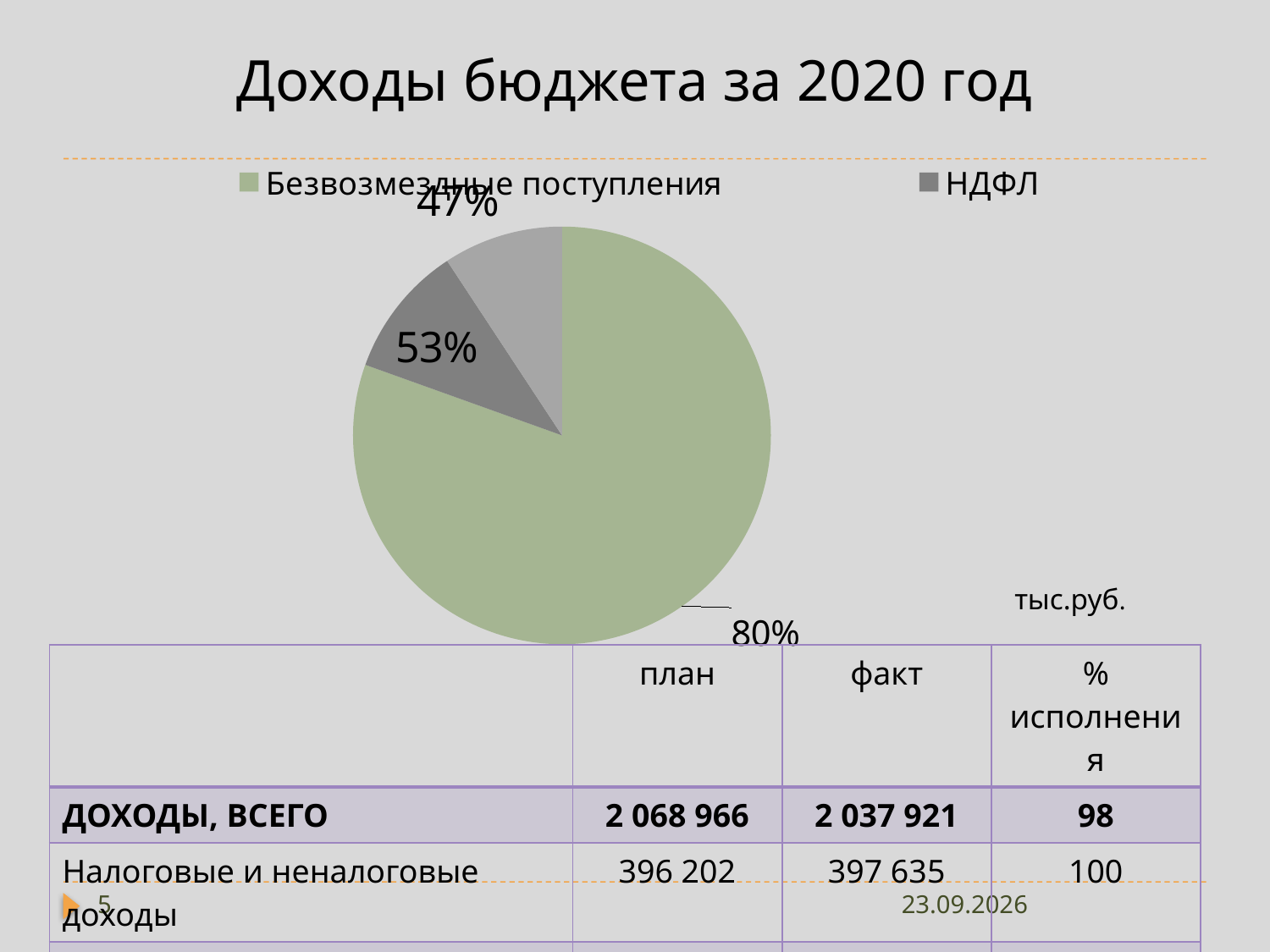
Which legend category has the largest slice of the pie? Безвозмездные поступления What data label is printed next to the large green slice of the pie? 80% Which is larger in the pie: the Безвозмездные поступления slice or the НДФЛ slice? Безвозмездные поступления What colour represents Безвозмездные поступления in the legend? green What colour represents НДФЛ in the legend? grey How many entries does the chart legend list? 2 What kind of chart is shown on the slide? pie chart Is the green slice of the pie greater or less than half of the pie? greater